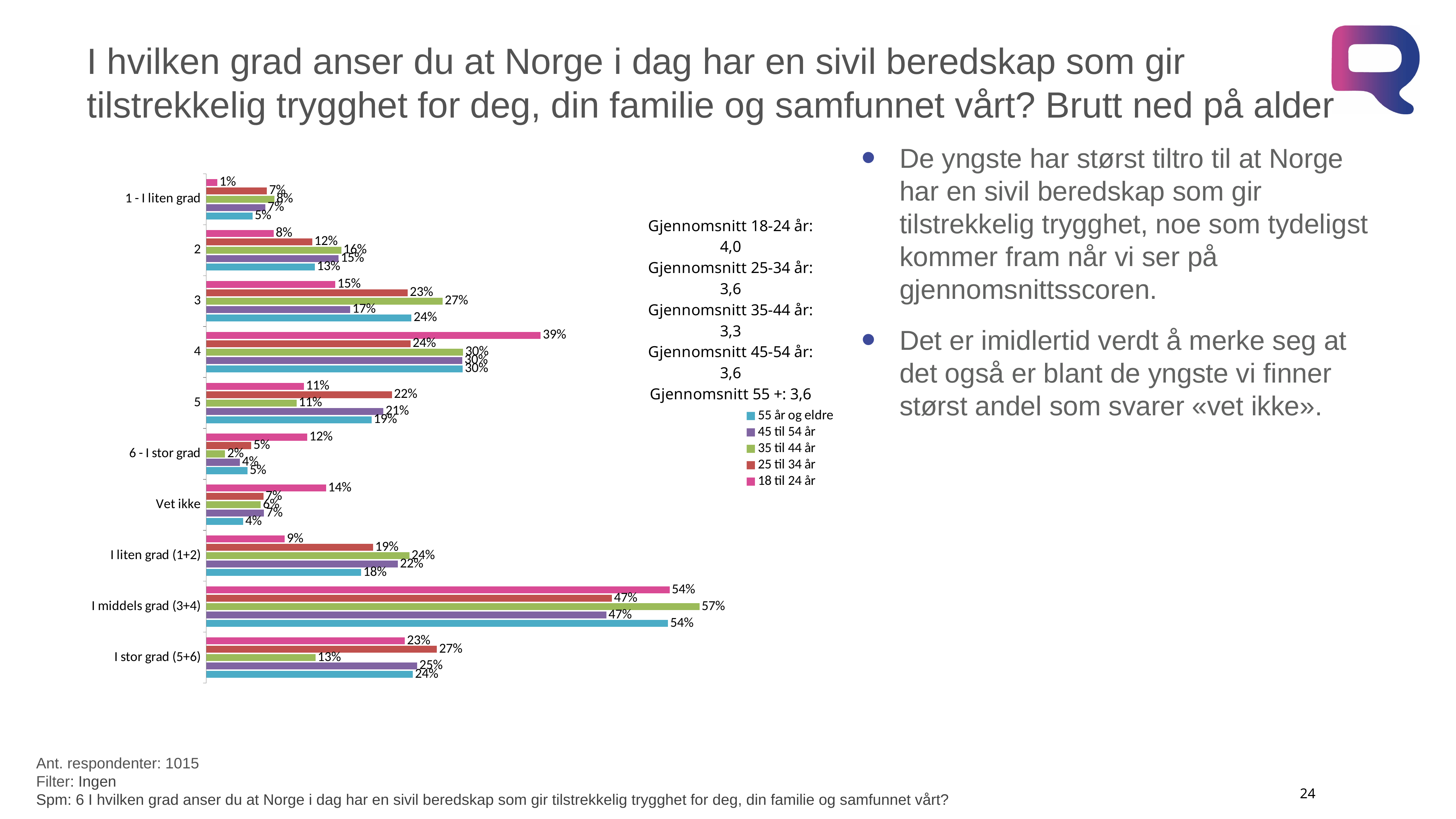
What is the value for the 18 til 24 år series in category 4? 39% Which age group has the highest value in category 4? 18 til 24 år What kind of chart is shown on the slide? Bar chart What is the difference between the 18 til 24 år value and the 55 år og eldre value in the category Vet ikke? 10 percentage points What is the Gjennomsnitt (average) shown for 18-24 år on the chart? 4,0 Which age group has the lowest value in the category I stor grad (5+6)? 35 til 44 år How many series does the legend list? 5 What is the value for the 25 til 34 år series in category 3? 23% In the category I liten grad (1+2), which is larger: the value for 35 til 44 år or for 18 til 24 år? 35 til 44 år What is the value for the 18 til 24 år series in the category Vet ikke? 14% What is the value for the 35 til 44 år series in the category I middels grad (3+4)? 57% How many categories are shown on the vertical axis of the chart? 10